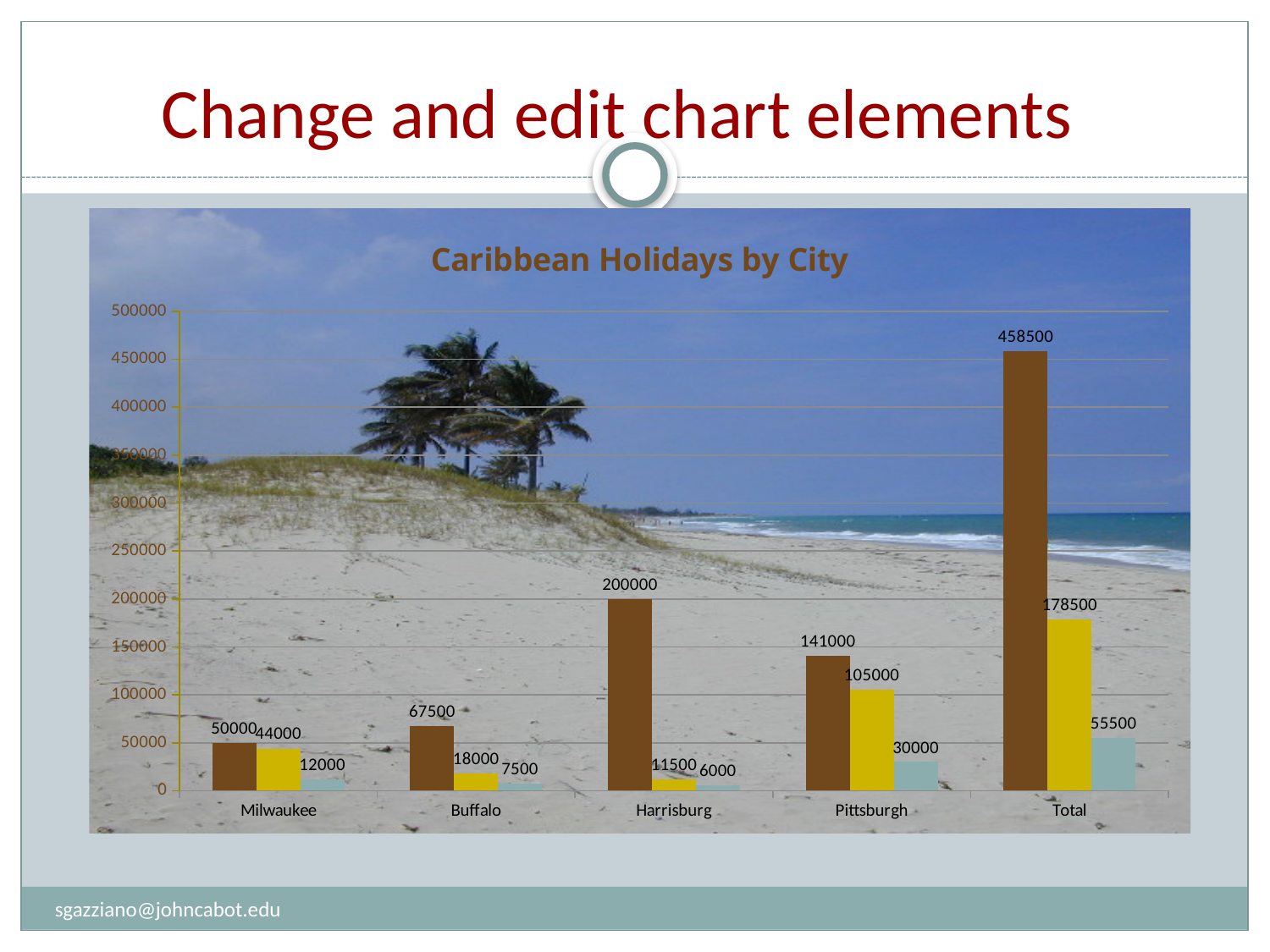
What is the title of the chart? Caribbean Holidays by City What is the value of the brown bar for Total? 458500 What is the value of the light blue bar for Milwaukee? 12000 Is the brown bar for Buffalo greater or less than 100000? less What is the value of the yellow bar for Pittsburgh? 105000 What kind of chart is shown on the slide? bar chart Among the individual cities (excluding Total), which city has the lowest light blue bar? Harrisburg Among the individual cities (excluding Total), which city has the highest brown bar? Harrisburg Which is larger, the yellow bar for Buffalo or the yellow bar for Milwaukee? Milwaukee What is the difference between the brown bar and the yellow bar for Pittsburgh? 36000 How many categories are shown on the x axis of the chart? 5 What is the value of the brown bar for Harrisburg? 200000